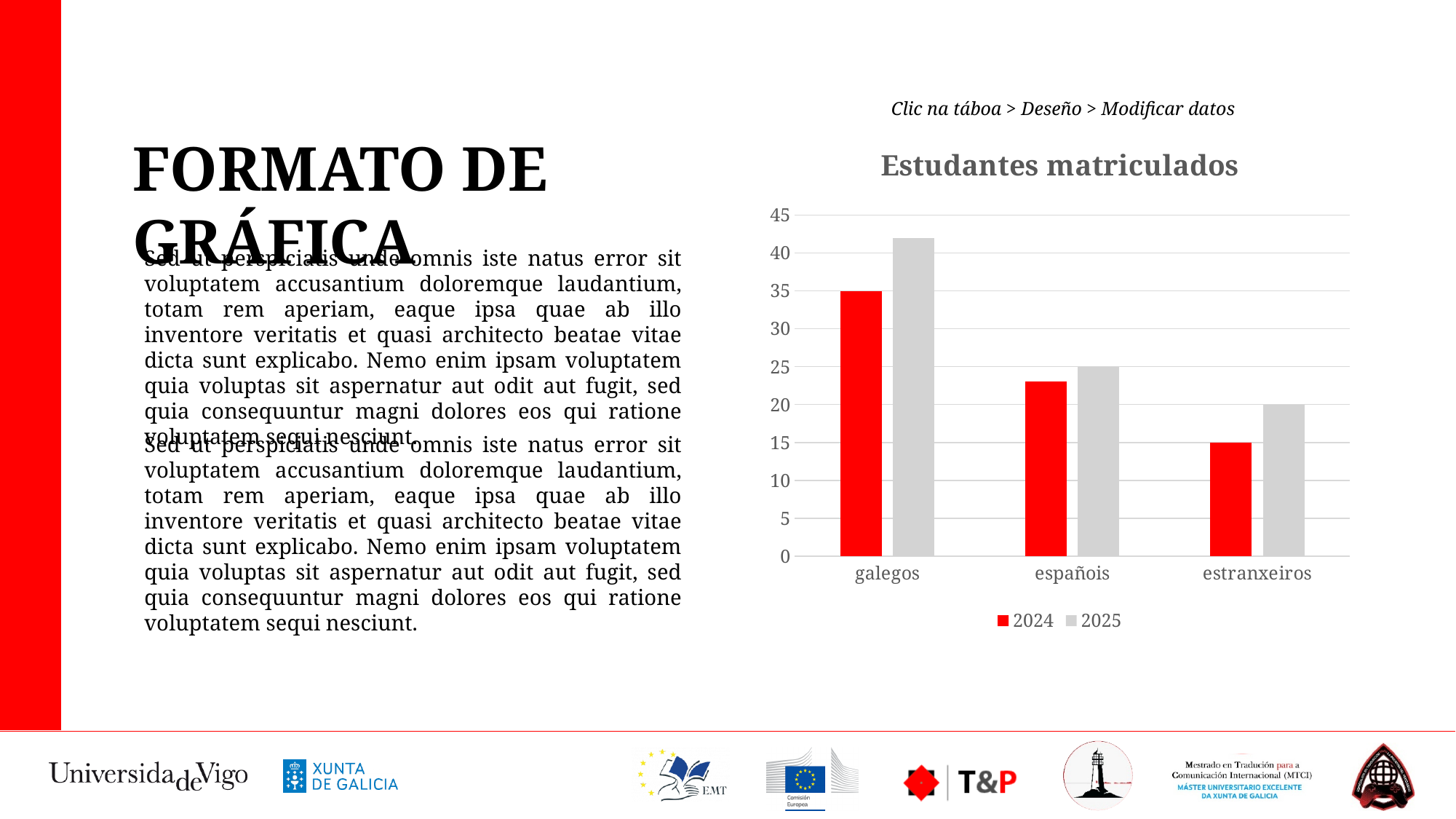
What is the value for galegos in the 2024 series? 35 How many categories are shown on the x axis of the chart? 3 What is the difference between the 2025 and 2024 values for estranxeiros? 5 Is the value for españois in the 2024 series greater or less than 25? less What is the title of the chart? Estudantes matriculados Do the 2024 values rise or fall from galegos to estranxeiros? fall What kind of chart is shown on the slide? bar chart Which category has the lowest value in the 2024 series? estranxeiros What is the value for estranxeiros in the 2025 series? 20 What is the value for españois in the 2025 series? 25 How many series does the chart's legend list? 2 Is the value for galegos in the 2025 series greater or less than 40? greater